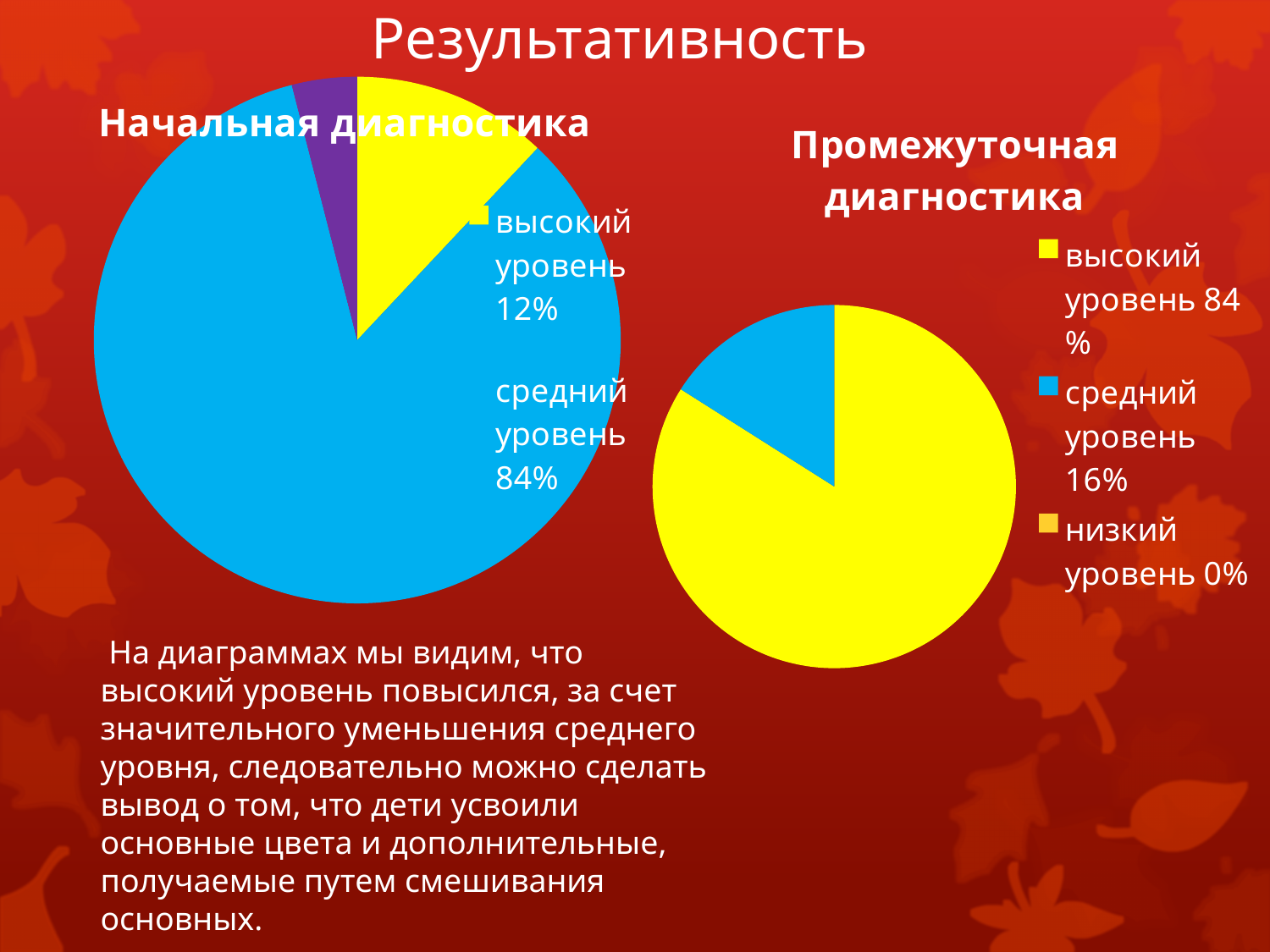
In the 'Промежуточная диагностика' chart, which category has the largest share? высокий уровень In the 'Начальная диагностика' chart, what share is 'высокий уровень'? 12% In the 'Промежуточная диагностика' chart, which category has the smallest share? низкий уровень In the 'Промежуточная диагностика' chart, what share is 'средний уровень'? 16% In the 'Начальная диагностика' chart, what share is 'средний уровень'? 84% How many categories does the legend of the 'Промежуточная диагностика' chart list? 3 In the 'Промежуточная диагностика' chart, what colour is the 'средний уровень' slice? blue In the 'Начальная диагностика' chart, which is larger: 'высокий уровень' or 'средний уровень'? средний уровень In the 'Начальная диагностика' chart, what is the difference between 'средний уровень' and 'высокий уровень'? 72% What kind of chart is used for 'Начальная диагностика'? pie chart